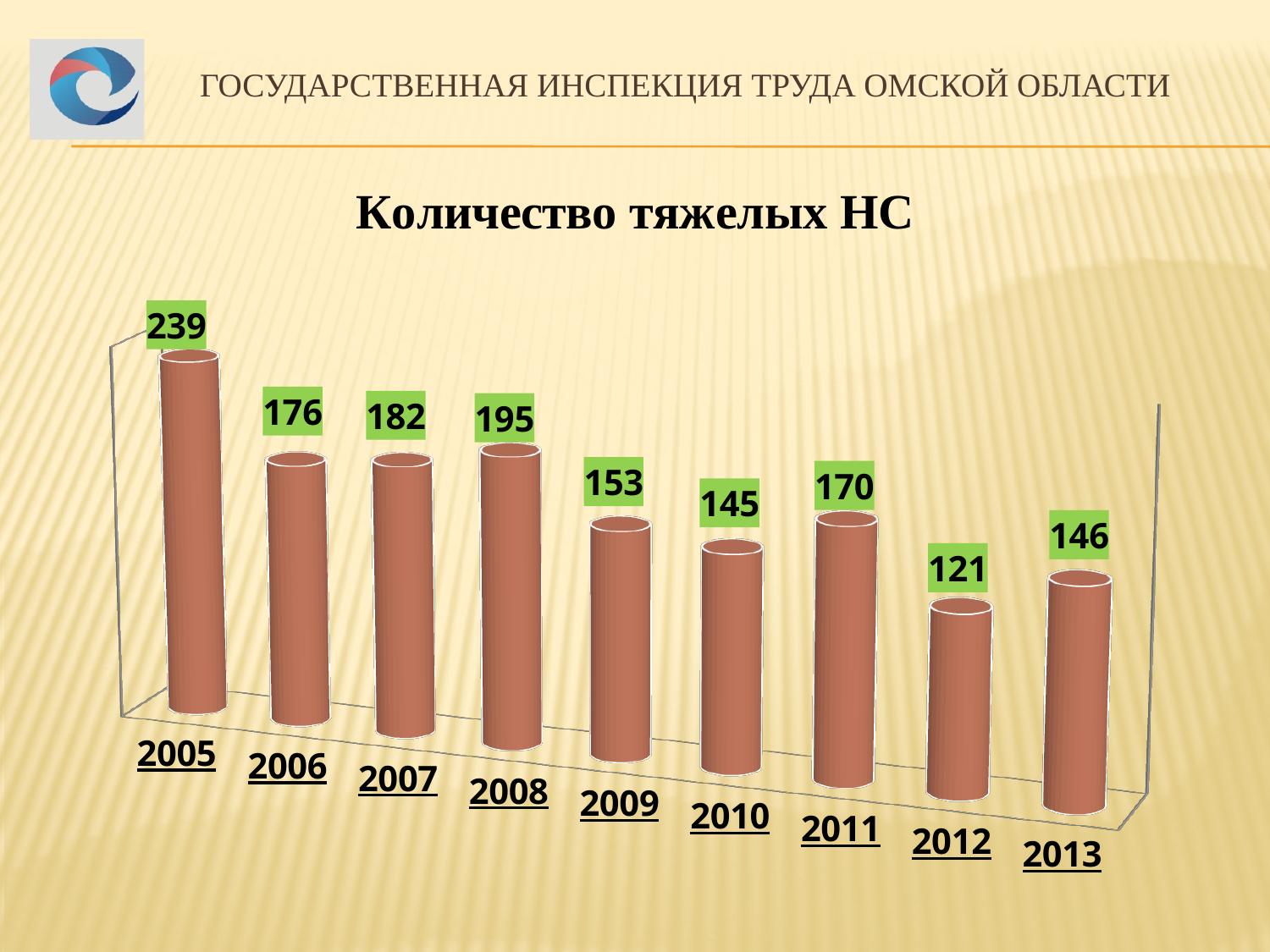
What is the value for 2009? 153 What is the title of the chart? Количество тяжелых НС Which is larger, the value for 2008 or the value for 2010? 2008 Which year has the lowest value? 2012 What is the value for 2005? 239 Do the values generally rise or fall from 2005 to 2013? fall How many years are shown on the chart? 9 What is the difference between the values for 2011 and 2012? 49 Which year has the highest value? 2005 What is the difference between the values for 2005 and 2006? 63 What kind of chart is shown on the slide? bar chart What is the value for 2013? 146